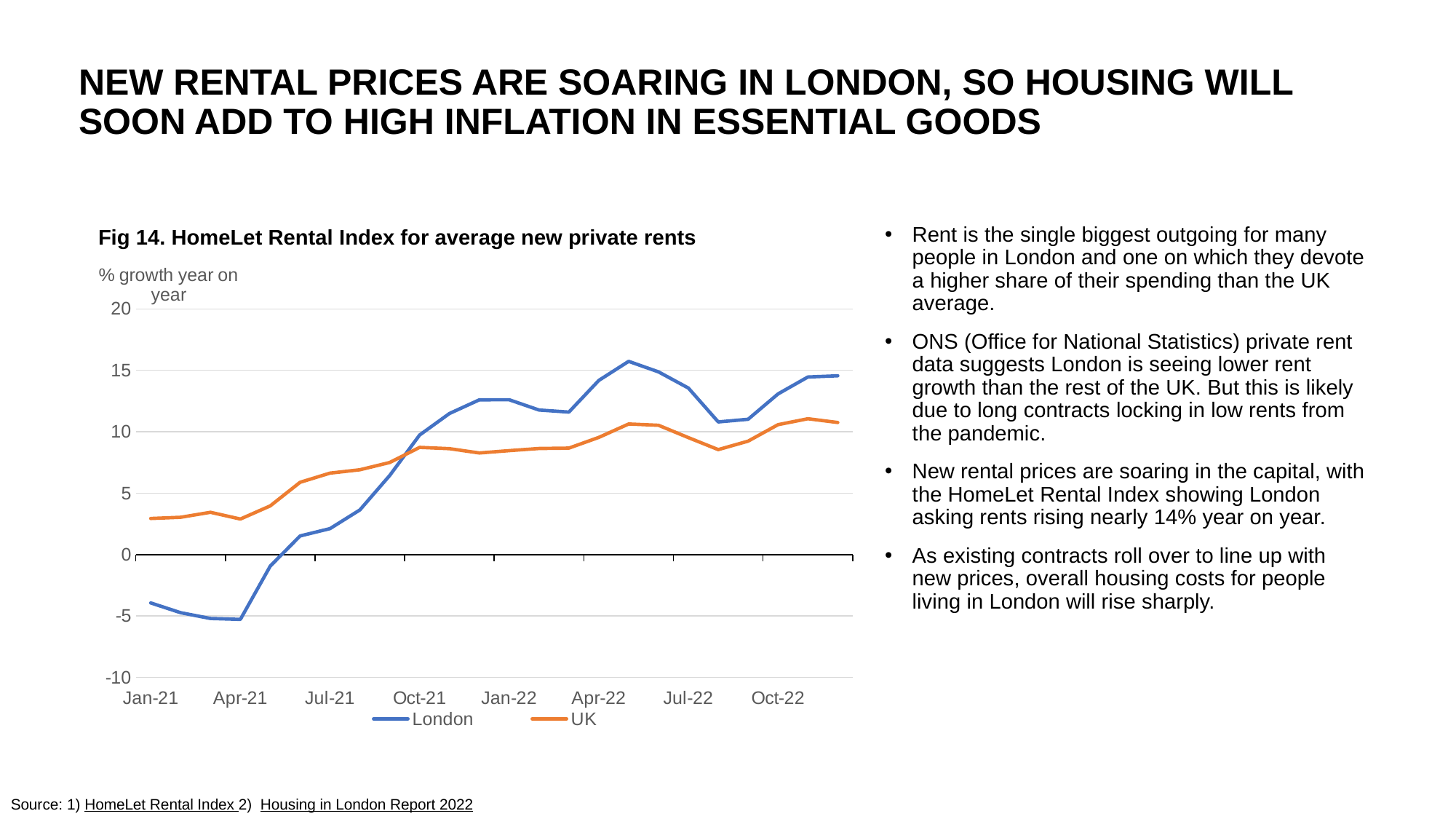
Does the London series rise or fall between Jan-21 and Apr-22? rise Is the value for London at Apr-22 greater or less than 10? greater Is the value for UK at Jan-21 greater or less than 0? greater What is the title of the chart on the slide? Fig 14. HomeLet Rental Index for average new private rents At Jan-21, which series has the higher value, London or UK? UK At Oct-22, which series has the higher value, London or UK? London Which two series are plotted in Fig 14? London and UK Is the value for UK at Apr-22 greater or less than 10? less What kind of chart is shown in Fig 14? line chart How many series does the legend of Fig 14 list? 2